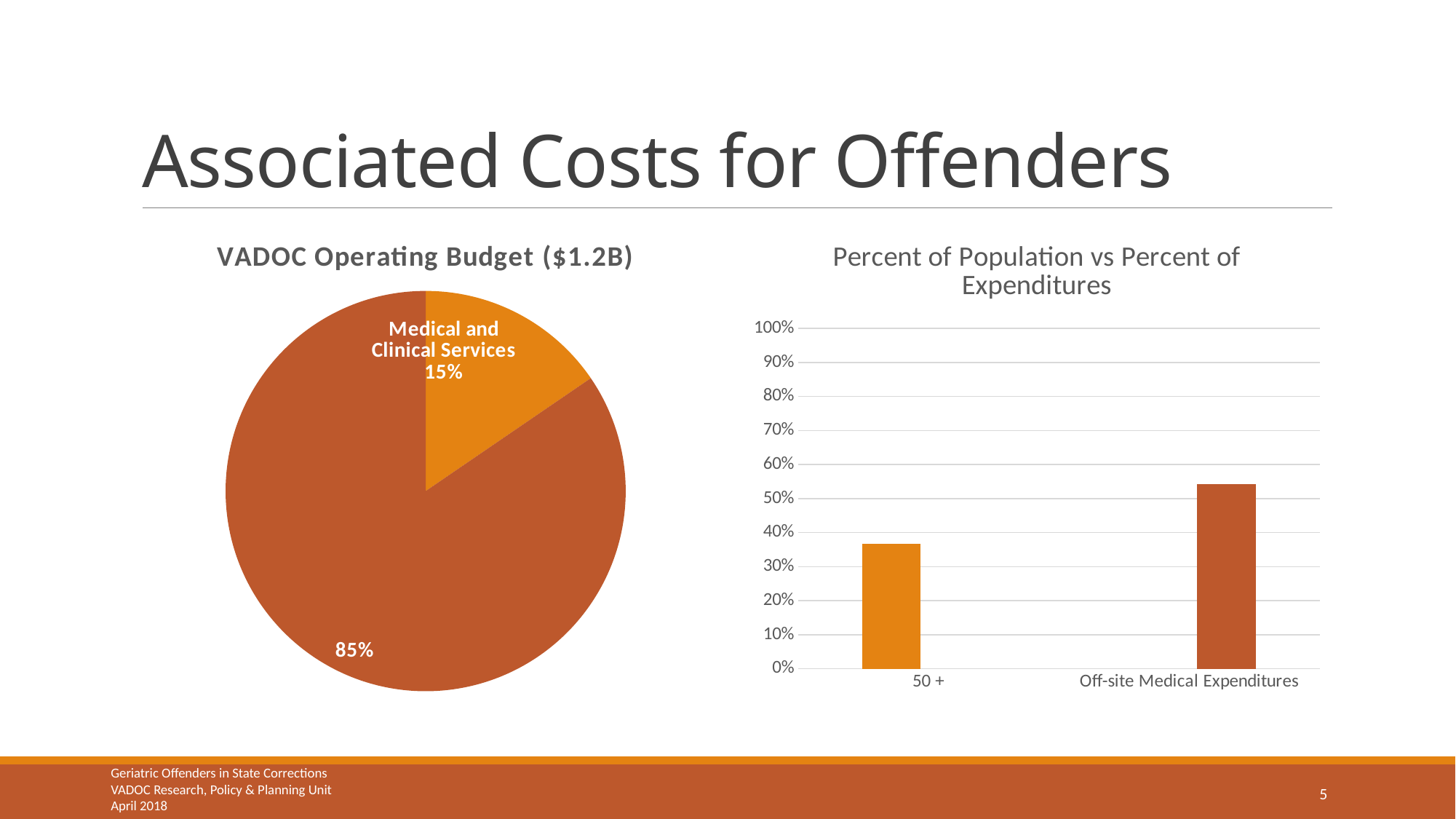
In the Percent of Population vs Percent of Expenditures chart, which category has the higher value? Off-site Medical Expenditures What is the total budget amount shown in the title of the pie chart on the left? $1.2B How many slices does the VADOC Operating Budget ($1.2B) pie chart have? 2 In the VADOC Operating Budget ($1.2B) pie chart, what share of the budget goes to Medical and Clinical Services? 15% What kind of chart is the Percent of Population vs Percent of Expenditures chart? Bar chart How many bars are in the Percent of Population vs Percent of Expenditures chart? 2 What kind of chart is the VADOC Operating Budget ($1.2B) chart? Pie chart In the VADOC Operating Budget ($1.2B) pie chart, what is the difference between the two slices' percentages? 70% In the Percent of Population vs Percent of Expenditures chart, is the value for Off-site Medical Expenditures greater or less than 50%? greater In the VADOC Operating Budget ($1.2B) pie chart, what percentage is shown on the larger slice? 85% In the Percent of Population vs Percent of Expenditures chart, is the value for 50 + greater or less than 40%? less In the Percent of Population vs Percent of Expenditures chart, which category has the lower value? 50 +